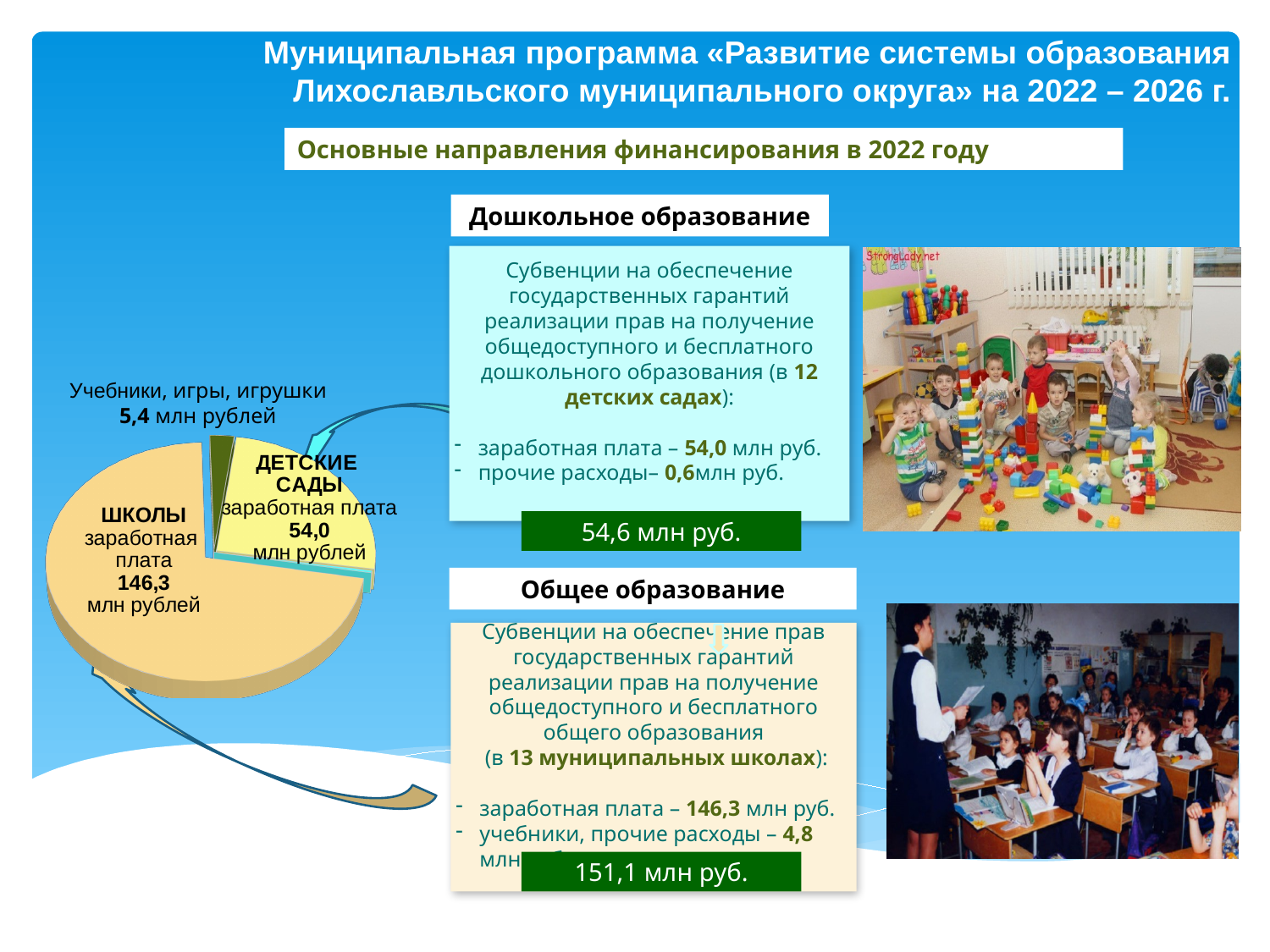
What is the value of the «Учебники, игры, игрушки» slice in the pie chart? 5,4 млн рублей What is the difference between the «ДЕТСКИЕ САДЫ заработная плата» slice and the «Учебники, игры, игрушки» slice in the pie chart? 48,6 млн рублей What is the value of the «ШКОЛЫ заработная плата» slice in the pie chart? 146,3 млн рублей What is the difference between the «ШКОЛЫ заработная плата» slice and the «ДЕТСКИЕ САДЫ заработная плата» slice in the pie chart? 92,3 млн рублей Which is larger in the pie chart: «ДЕТСКИЕ САДЫ заработная плата» or «Учебники, игры, игрушки»? ДЕТСКИЕ САДЫ заработная плата What kind of chart is shown on the slide? Pie chart Which slice of the pie chart is shown in dark green? Учебники, игры, игрушки What is the total of all three slices in the pie chart? 205,7 млн рублей Which slice of the pie chart is the smallest? Учебники, игры, игрушки What is the value of the «ДЕТСКИЕ САДЫ заработная плата» slice in the pie chart? 54,0 млн рублей Which slice of the pie chart is the largest? ШКОЛЫ заработная плата